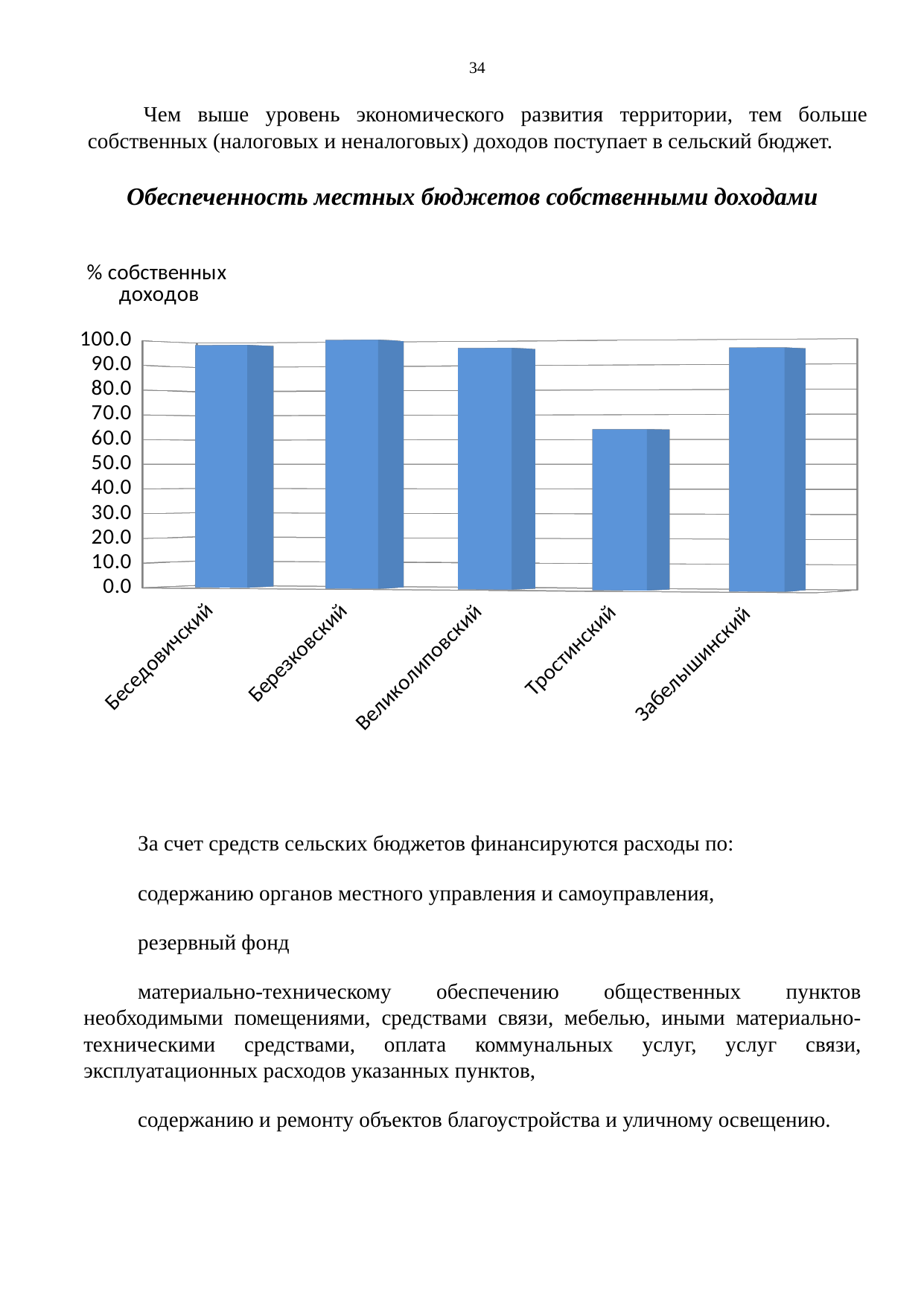
Is the value for Беседовичский greater or less than 90.0? greater What is the label of the vertical axis of the chart? % собственных доходов Is the value for Великолиповский greater or less than 90.0? greater Which category has the lowest value in the chart? Тростинский Is the value for Тростинский greater or less than 60.0? greater What is the title of the chart? Обеспеченность местных бюджетов собственными доходами Which is larger, the value for Тростинский or the value for Забельшинский? Забельшинский How many categories (rural councils) are shown on the x axis of the chart? 5 Which is larger, the value for Березковский or the value for Тростинский? Березковский What kind of chart is shown on the slide? Bar chart